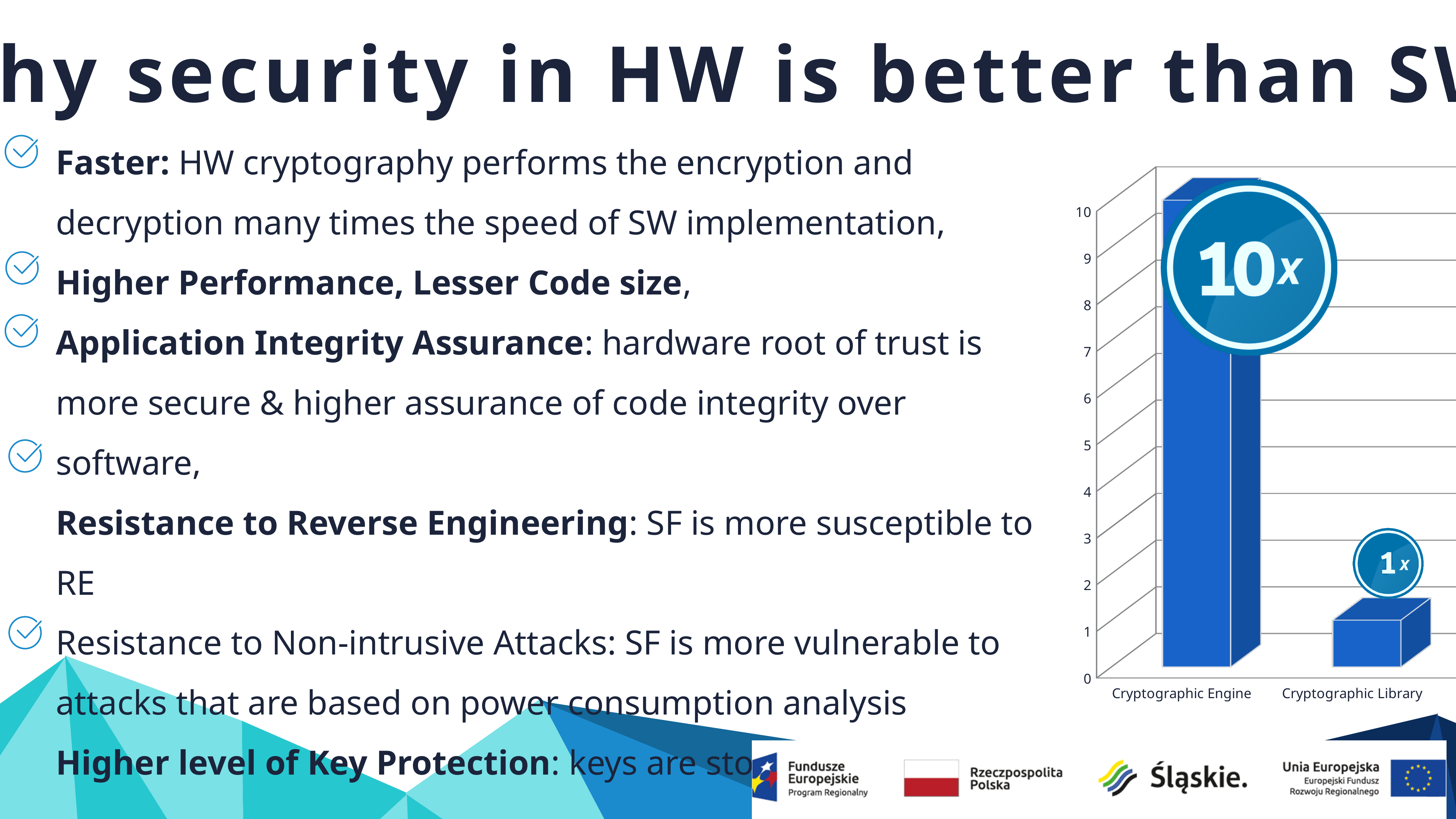
What kind of chart is shown on the slide? bar chart How many categories are shown on the x axis of the chart? 2 Which is larger, the value for Cryptographic Engine or for Cryptographic Library? Cryptographic Engine Which category has the highest bar? Cryptographic Engine Is the value for Cryptographic Engine greater or less than 5? greater Which category has the lowest bar? Cryptographic Library What value is labelled on the bar for Cryptographic Library? 1x What value is labelled on the bar for Cryptographic Engine? 10x Do the bar values rise or fall from Cryptographic Engine to Cryptographic Library? fall Is the value for Cryptographic Library greater or less than 5? less What is the label of the first category on the x axis of the chart? Cryptographic Engine What is the highest tick value shown on the vertical axis of the chart? 10